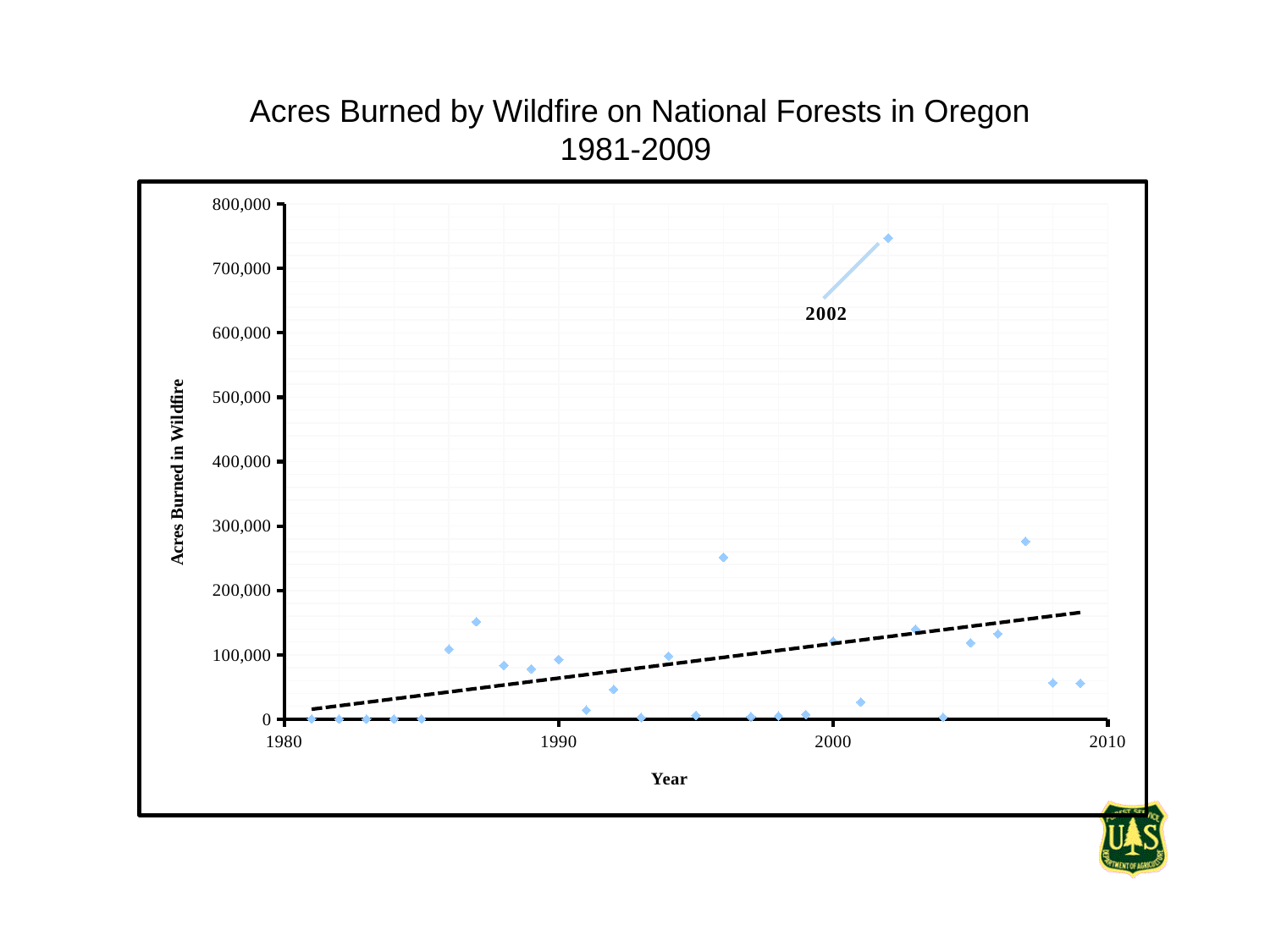
Is the value for 1987 greater or less than 100,000? greater Is the value for 2002 greater or less than 700,000? greater Which year has the highest number of acres burned? 2002 Which year had more acres burned, 2002 or 2007? 2002 What is the title of the vertical axis? Acres Burned in Wildfire What kind of chart is shown on the slide? scatter chart Is the value for 2007 greater or less than 200,000? greater Which year had more acres burned, 1996 or 1987? 1996 Does the dashed trend line rise or fall from 1980 to 2010? rises